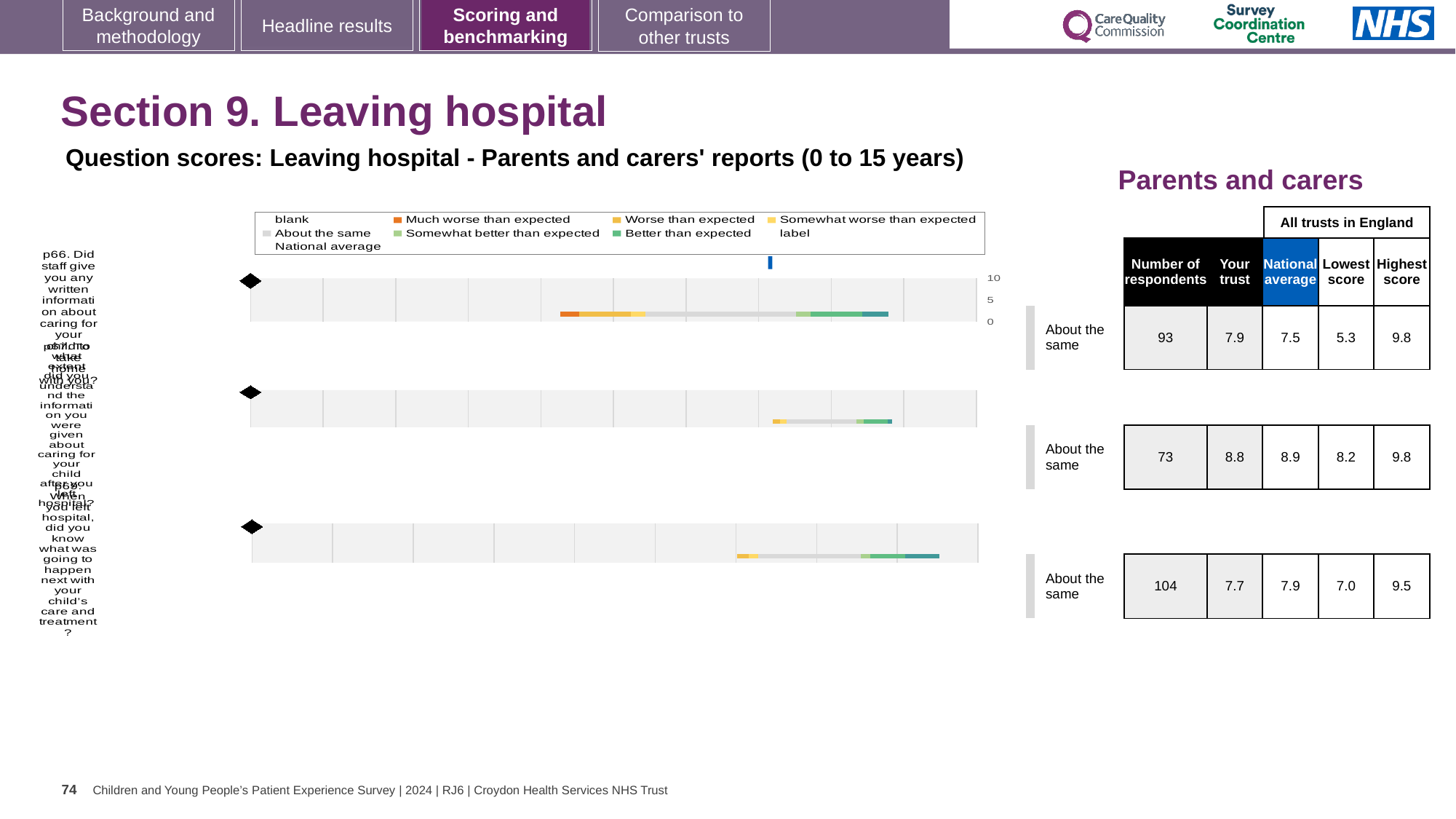
For the top question row (p66), what is the 'Your trust' score? 7.9 For the top question row (p66), how many respondents are shown in the table? 93 For the top question row (p66), which is larger: the 'Your trust' score or the national average? Your trust For the bottom question row, what is the highest score among all trusts in England? 9.5 How many question rows (bars) are plotted on the slide? 3 What kind of chart is used to show the question scores on this slide? bar chart In the chart legend, which colour represents 'Much worse than expected'? orange For the middle question row, what is the difference between the highest score (9.8) and the lowest score (8.2)? 1.6 Which question row has the largest number of respondents? the bottom row (104) For the middle question row, what is the national average score? 8.9 For the bottom question row, what is the lowest score among all trusts in England? 7.0 What benchmark category is shown for the bottom question row? About the same